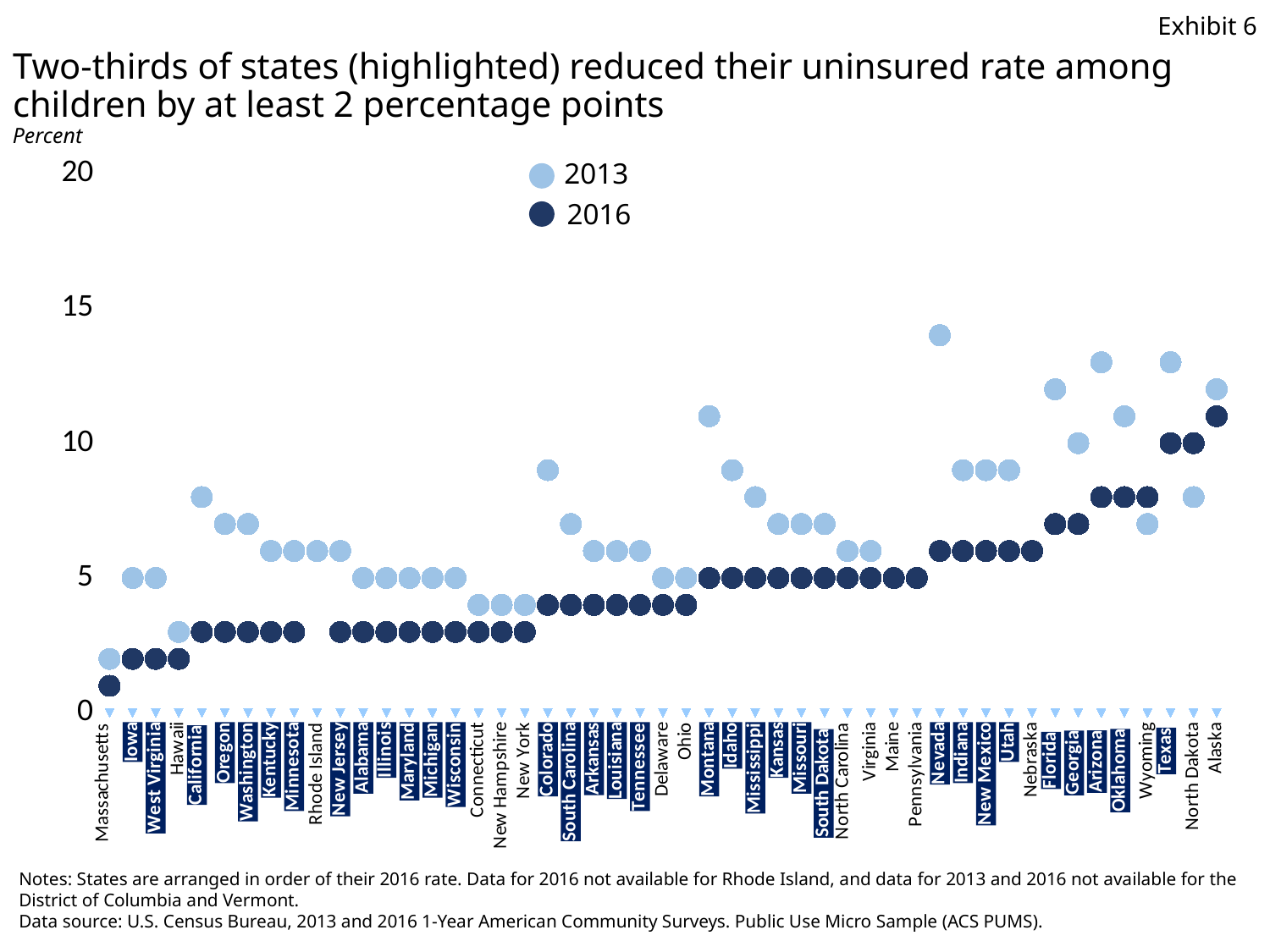
Is the 2016 value for Massachusetts greater or less than 5? less Is the 2013 value for Nevada greater or less than 10? greater Which state has the lowest 2016 uninsured rate among children? Massachusetts For Texas, which is larger: the 2013 value or the 2016 value? 2013 What kind of chart is shown on the slide? Dot plot (scatter chart) Which state has the highest 2016 uninsured rate among children? Alaska Is the 2013 value for Colorado greater or less than 5? greater Which state has the highest 2013 uninsured rate among children? Nevada Do the 2016 values rise or fall moving from left to right along the x axis? rise How many states are listed along the x axis? 49 Which two years are shown in the legend? 2013 and 2016 How many series does the legend list? 2